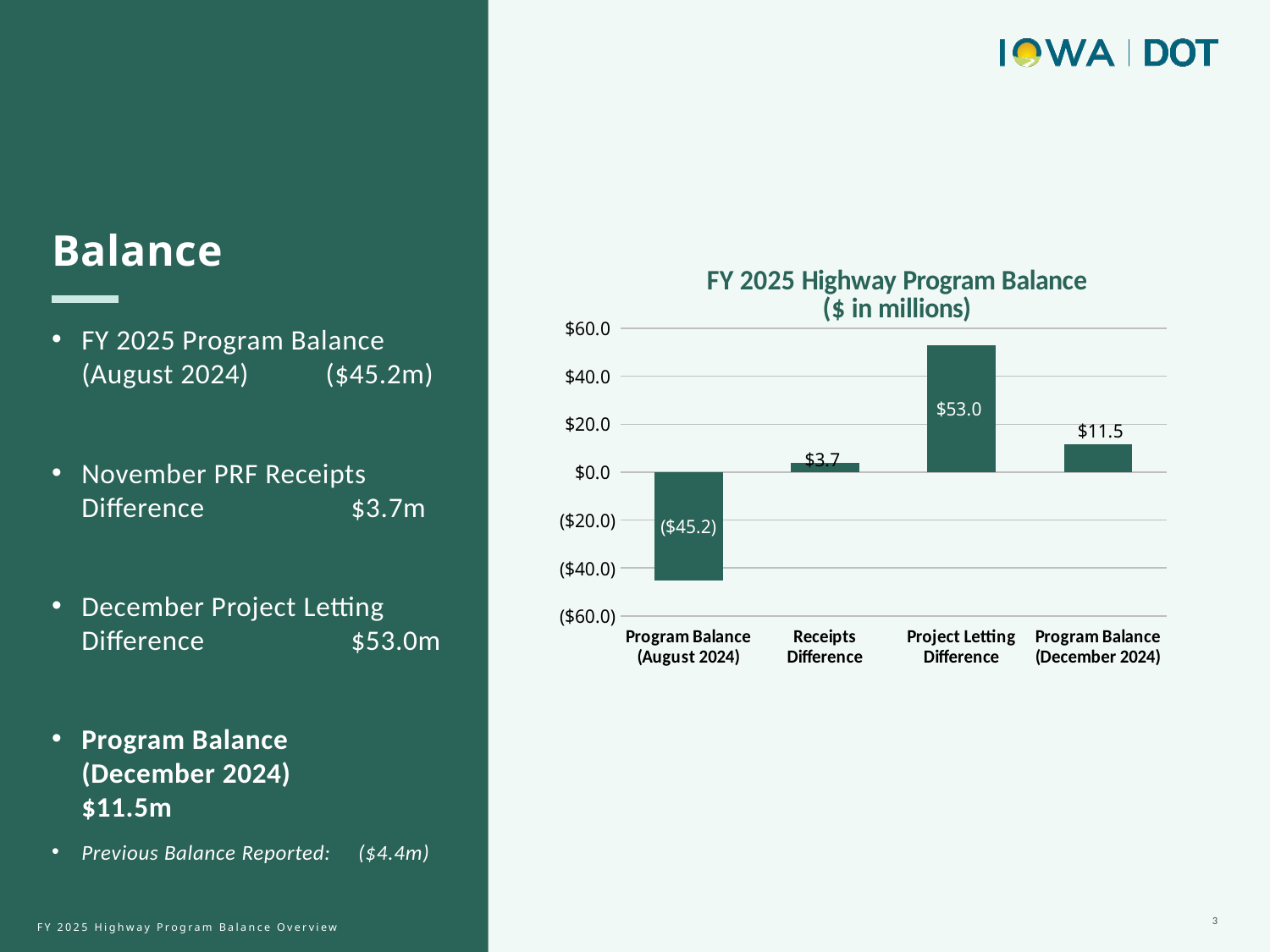
What kind of chart is shown? bar chart Is the value for Project Letting Difference greater or less than $40.0? greater What is the value for Project Letting Difference? $53.0 What is the title of the chart? FY 2025 Highway Program Balance ($ in millions) How many categories are shown on the x axis? 4 What is the value for Program Balance (December 2024)? $11.5 What is the difference between Project Letting Difference and Program Balance (December 2024)? $41.5 Which category has the lowest value? Program Balance (August 2024) Which is larger, Receipts Difference or Program Balance (December 2024)? Program Balance (December 2024) Which category has the highest value? Project Letting Difference What is the value for Program Balance (August 2024)? ($45.2) What is the value for Receipts Difference? $3.7